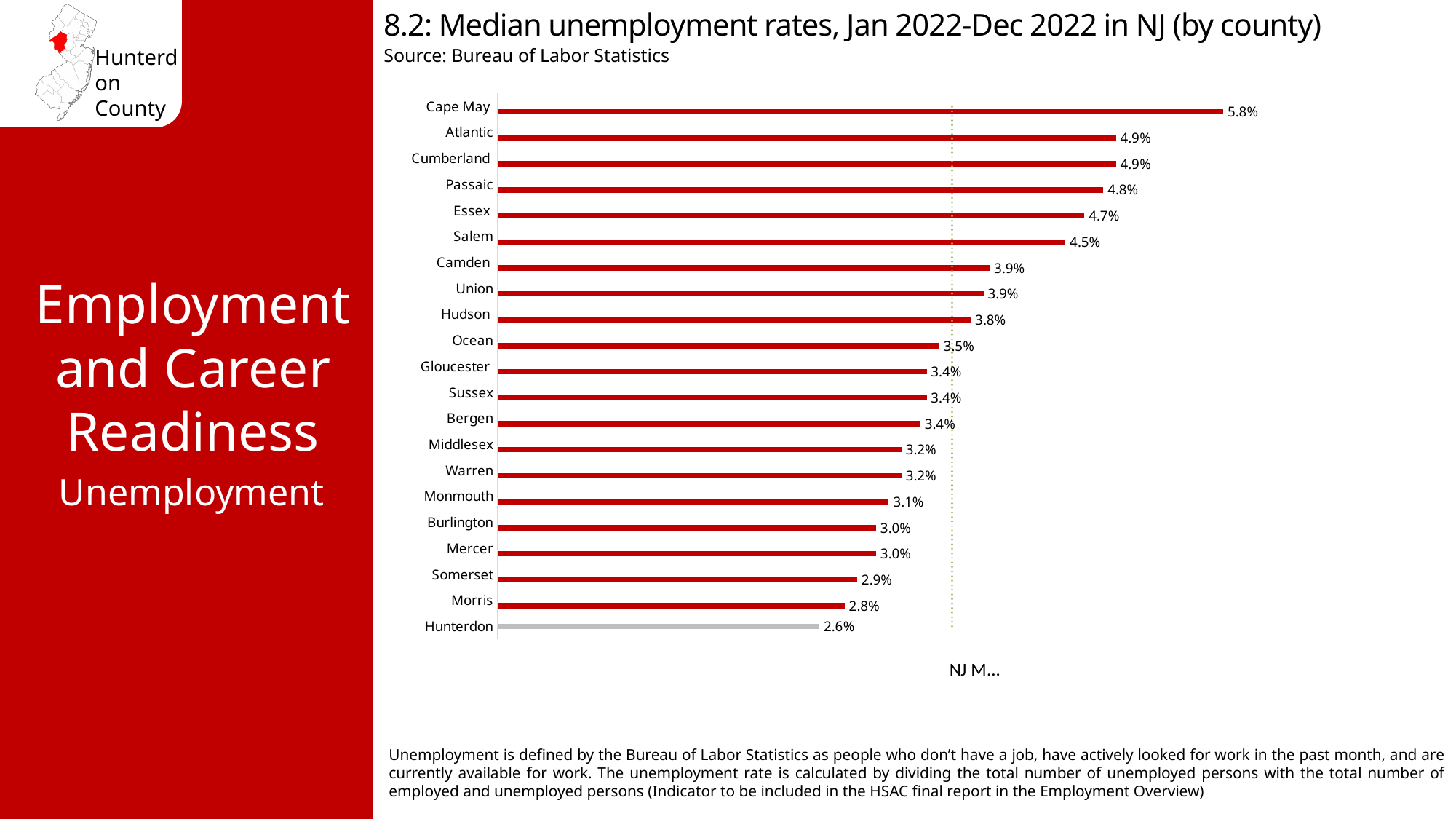
What is the median unemployment rate for Cape May? 5.8% What is the median unemployment rate for Hunterdon? 2.6% How many counties are shown in the chart? 21 What is the median unemployment rate for Monmouth? 3.1% What is the difference between the median unemployment rates of Essex and Morris? 1.9% Which county has the lowest median unemployment rate? Hunterdon Which has a higher median unemployment rate, Passaic or Camden? Passaic What is the median unemployment rate for Salem? 4.5% What is the difference between the median unemployment rates of Cape May and Hunterdon? 3.2% Which county has the highest median unemployment rate? Cape May Which county's bar is shown in grey rather than red? Hunterdon What kind of chart is shown on the slide? Bar chart